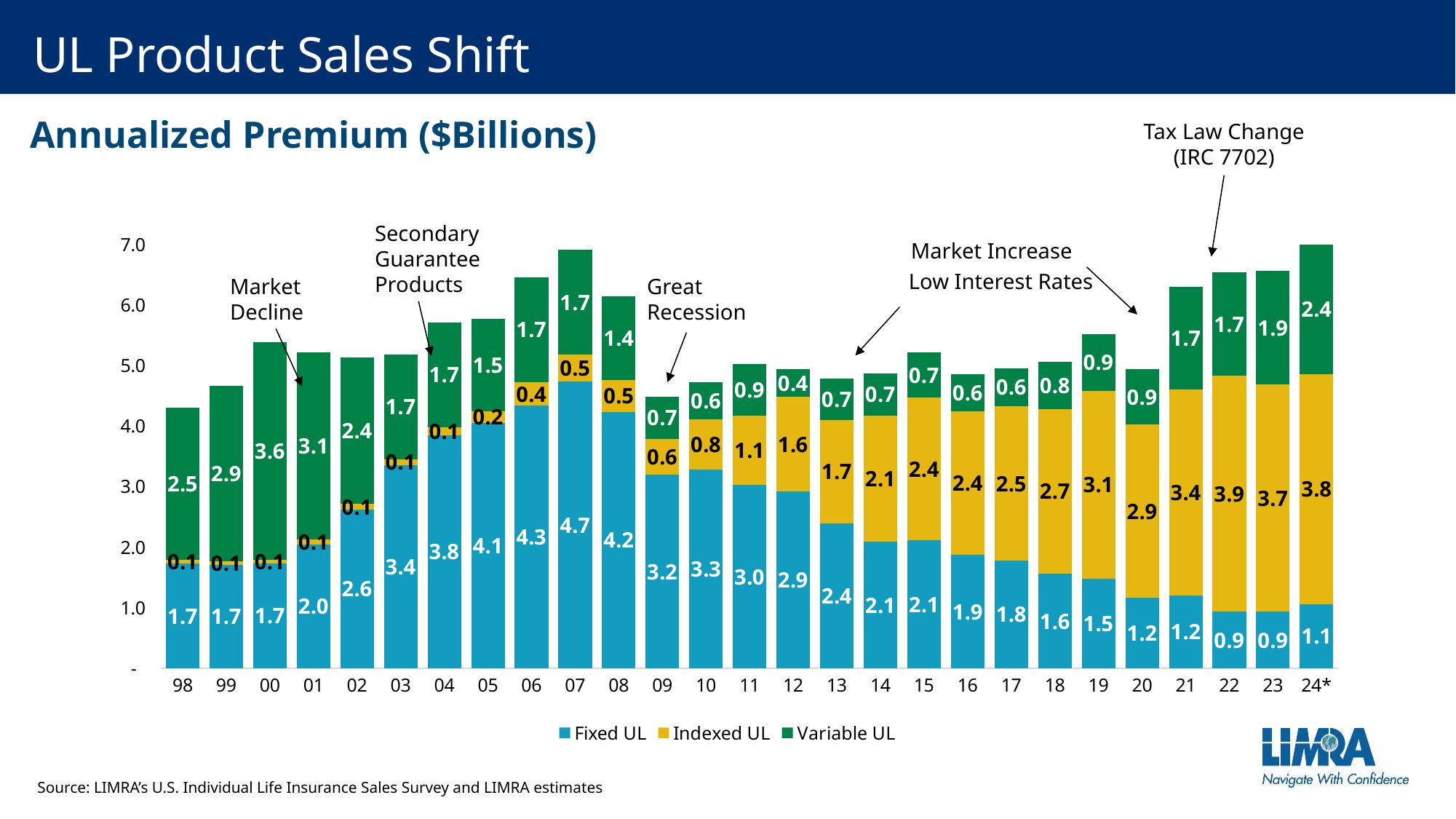
For 13, which is larger: Fixed UL or Indexed UL? Fixed UL What is the Fixed UL annualized premium for 07? 4.7 What is the difference between the Indexed UL values for 21 and 20? 0.5 Does the Fixed UL value rise or fall from 07 to 22? Fall In which year is the Fixed UL value highest? 07 What is the Indexed UL annualized premium for 22? 3.9 What is the total annualized premium for 07, summing the three segments? 6.9 How many years are shown along the x axis? 27 What kind of chart is shown on the slide? Stacked bar chart What is the Variable UL annualized premium for 24*? 2.4 How many series does the legend list? 3 In which year is the Variable UL value highest? 00